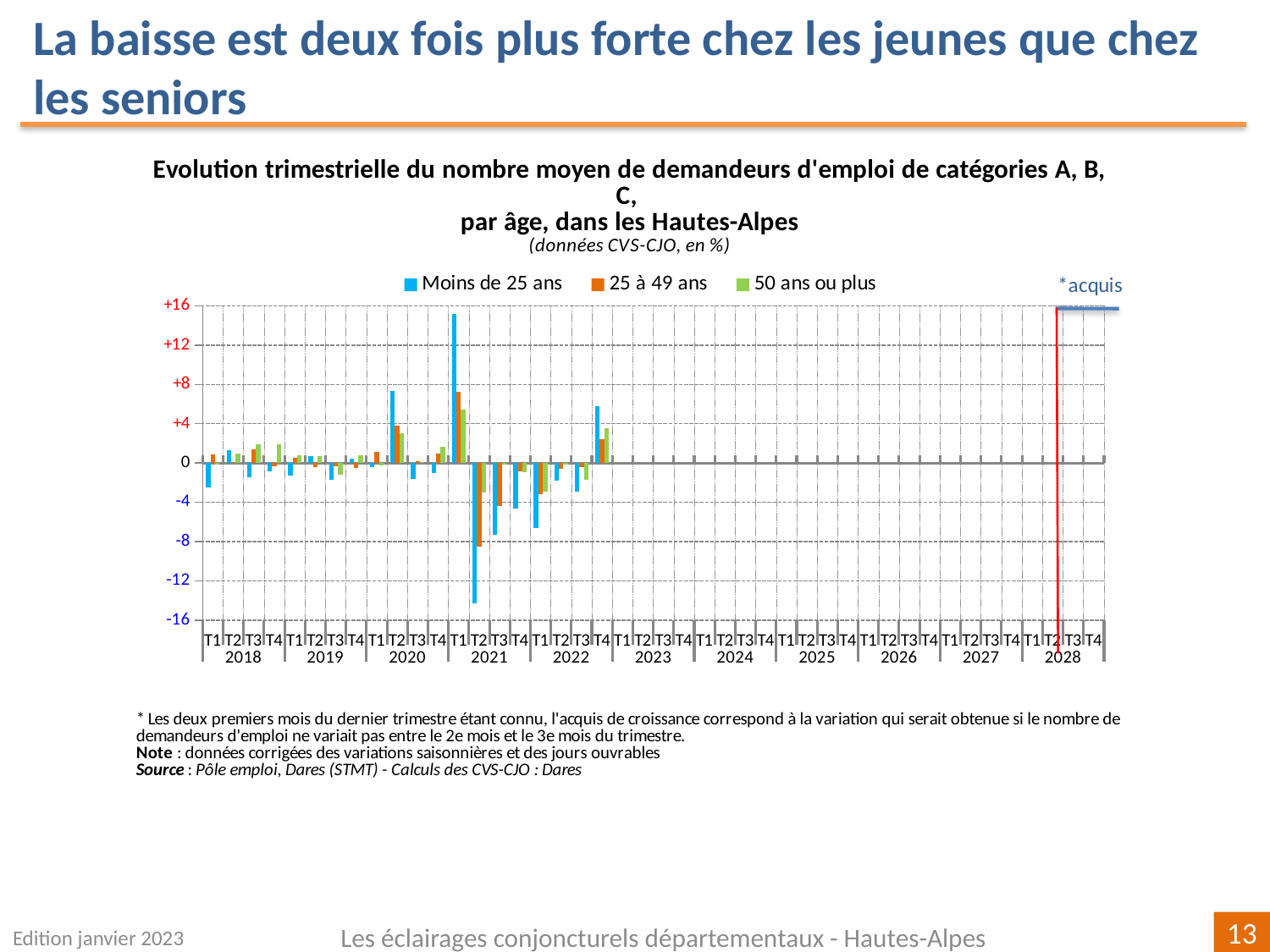
Is the value for Moins de 25 ans in T2 2021 greater or less than -12? less What kind of chart is shown on the slide? bar chart Is the value for Moins de 25 ans in T1 2021 greater or less than +12? greater In which quarter does the Moins de 25 ans series reach its highest value? T1 2021 Is the value for 25 à 49 ans in T1 2021 greater or less than +4? greater In which quarter does the Moins de 25 ans series reach its lowest value? T2 2021 How many series does the legend list? 3 What are the three series listed in the legend? Moins de 25 ans, 25 à 49 ans, 50 ans ou plus How many years are labelled along the x axis? 11 In T1 2021, which series has the larger value: Moins de 25 ans or 50 ans ou plus? Moins de 25 ans What label appears next to the red vertical line at the right of the chart? *acquis